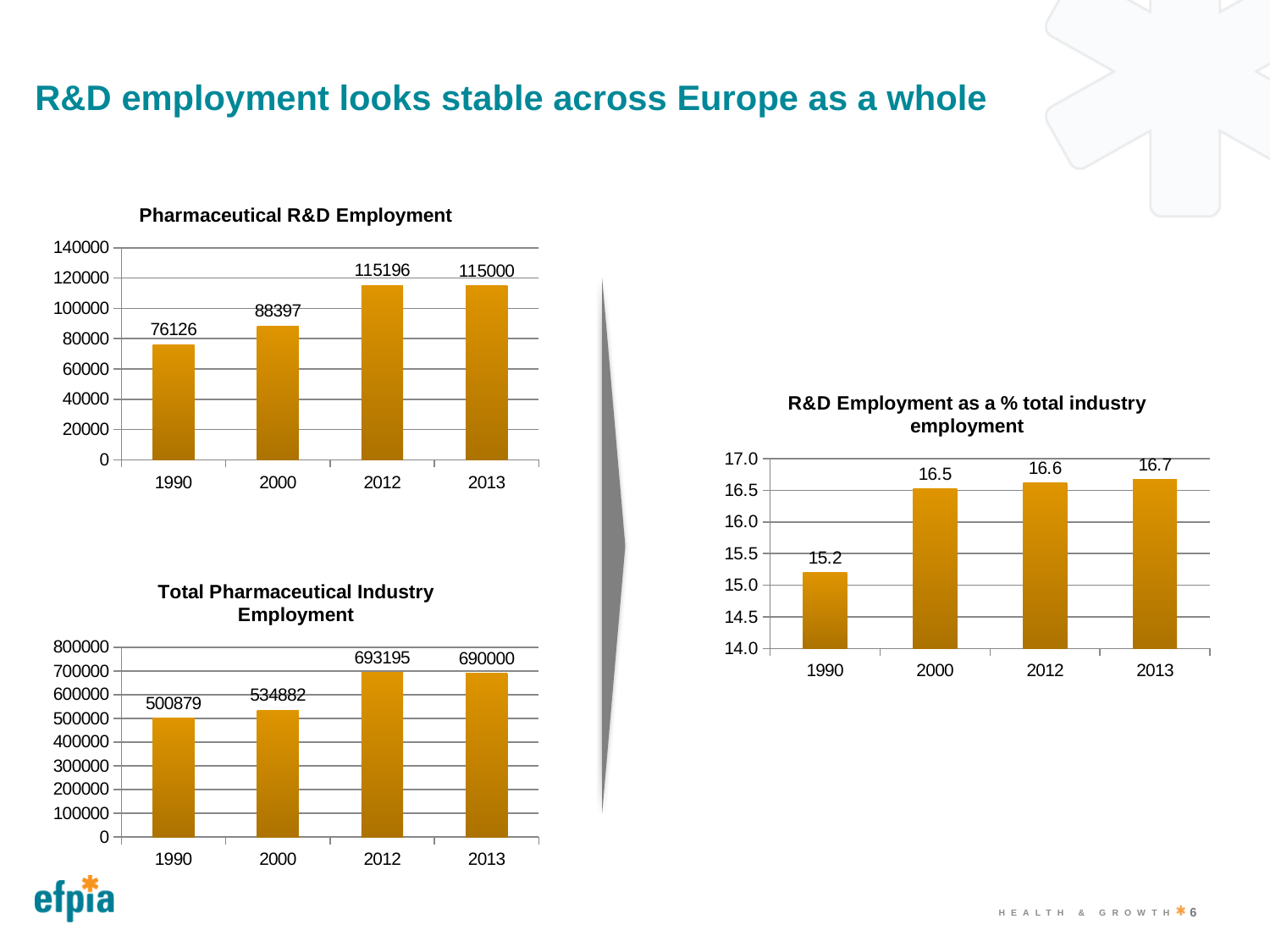
How many years are shown on the x axis of the 'Pharmaceutical R&D Employment' chart? 4 In the 'R&D Employment as a % total industry employment' chart, is the value for 2000 larger or smaller than the value for 1990? larger In the 'Pharmaceutical R&D Employment' chart, what is the difference between the 2012 and 1990 values? 39070 What kind of chart is the 'Total Pharmaceutical Industry Employment' chart? bar chart In the 'Total Pharmaceutical Industry Employment' chart, what is the difference between the 2000 and 1990 values? 34003 In the 'Pharmaceutical R&D Employment' chart, what is the value for 2000? 88397 In the 'R&D Employment as a % total industry employment' chart, what is the value for 1990? 15.2 In the 'R&D Employment as a % total industry employment' chart, which year has the highest value? 2013 In the 'R&D Employment as a % total industry employment' chart, do the values rise or fall from 1990 to 2013? rise In the 'Total Pharmaceutical Industry Employment' chart, which year has the lowest value? 1990 In the 'Total Pharmaceutical Industry Employment' chart, what is the value for 2013? 690000 In the 'Pharmaceutical R&D Employment' chart, which year has the highest value? 2012